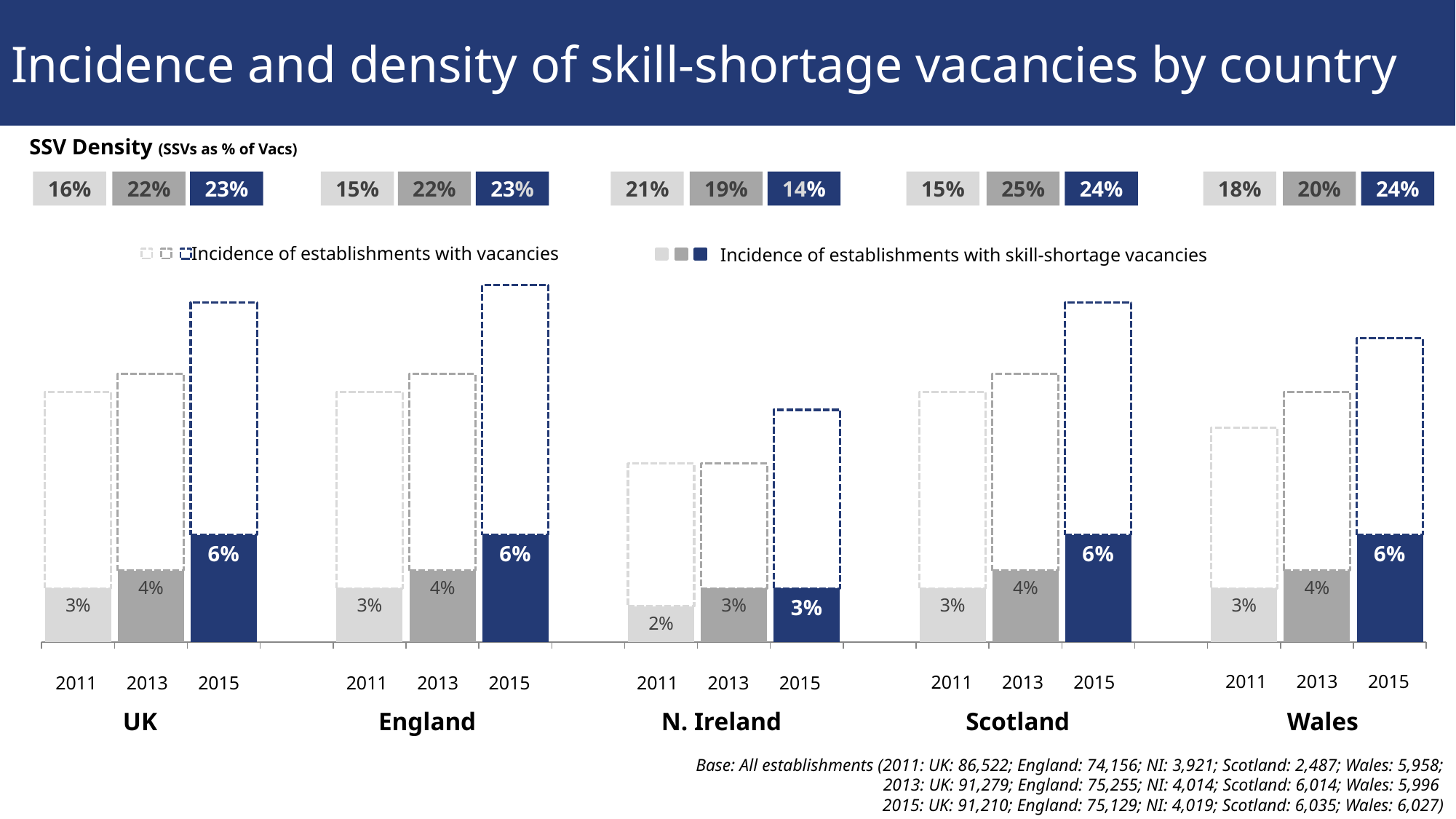
In 2015, which has the larger incidence of establishments with skill-shortage vacancies, N. Ireland or Scotland? Scotland How many series does the legend list? 2 Which country has the lowest SSV density in 2015? N. Ireland Which country has the highest SSV density in 2013? Scotland What is the SSV density for N. Ireland in 2015? 14% Does the SSV density for N. Ireland rise or fall from 2011 to 2015? Fall How many countries are shown in the chart? 5 What is the incidence of establishments with skill-shortage vacancies in N. Ireland in 2011? 2% By how many percentage points did the incidence of establishments with skill-shortage vacancies in the UK increase from 2011 to 2015? 3 percentage points What is the SSV density for Scotland in 2013? 25% What is the incidence of establishments with skill-shortage vacancies in the UK in 2015? 6% Which country has the lowest incidence of establishments with skill-shortage vacancies in 2011? N. Ireland